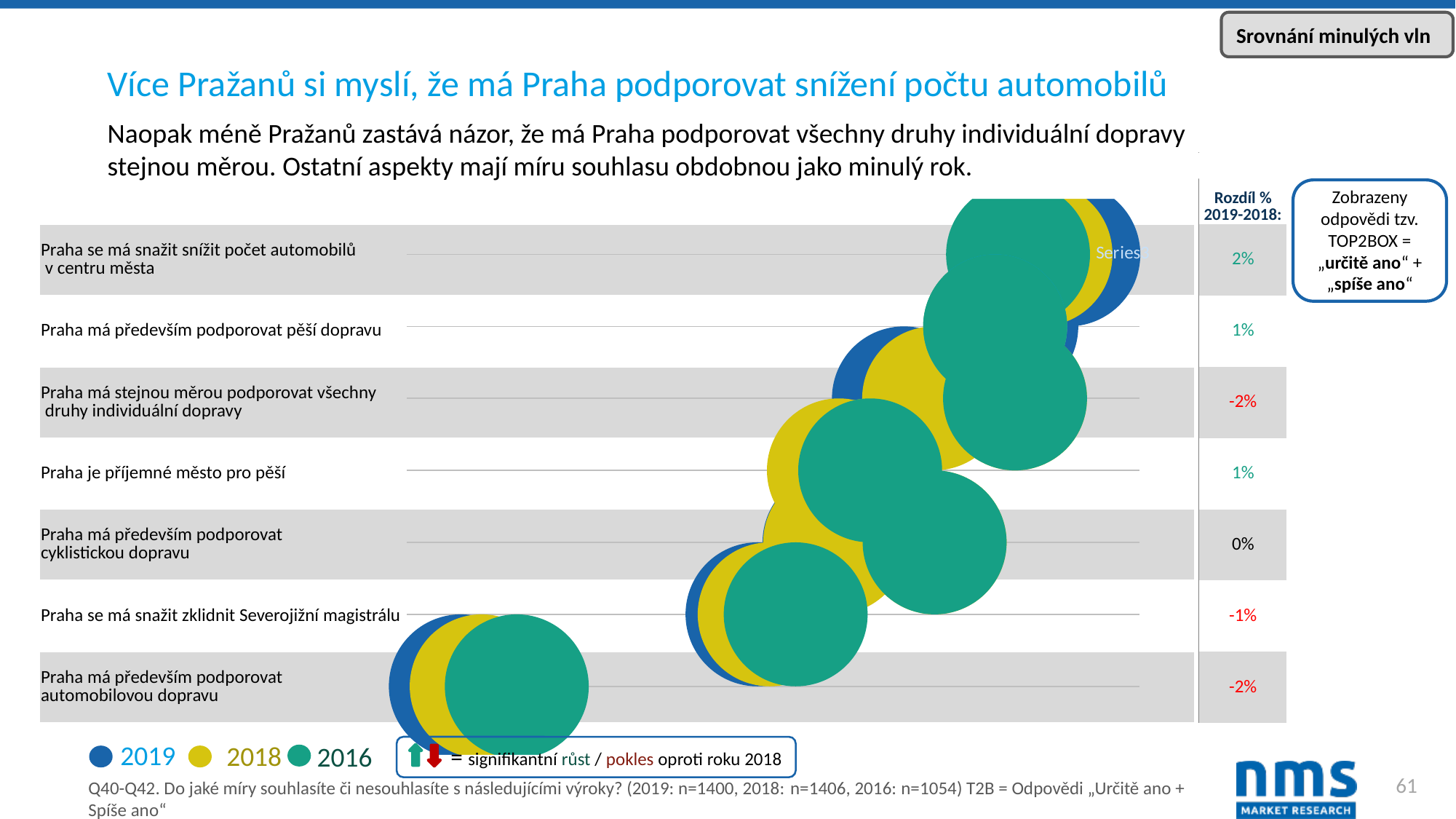
What is the 'Rozdíl % 2019-2018' value for 'Praha má stejnou měrou podporovat všechny druhy individuální dopravy'? -2% Which years are listed in the chart legend? 2019, 2018, 2016 What is the 'Rozdíl % 2019-2018' value for 'Praha se má snažit snížit počet automobilů v centru města'? 2% What is the 'Rozdíl % 2019-2018' value for 'Praha se má snažit zklidnit Severojižní magistrálu'? -1% Which statement has the lowest level of agreement (bubbles furthest to the left) on the chart? Praha má především podporovat automobilovou dopravu How many statements (categories) are plotted on the chart? 7 Which statement has the highest 'Rozdíl % 2019-2018' value? Praha se má snažit snížit počet automobilů v centru města What is the 'Rozdíl % 2019-2018' value for 'Praha má především podporovat pěší dopravu'? 1% What is the 'Rozdíl % 2019-2018' value for 'Praha má především podporovat cyklistickou dopravu'? 0% Which colour represents the year 2019 in the chart? Blue Which statement has the highest level of agreement (bubbles furthest to the right) on the chart? Praha se má snažit snížit počet automobilů v centru města How many series does the chart legend list? 3